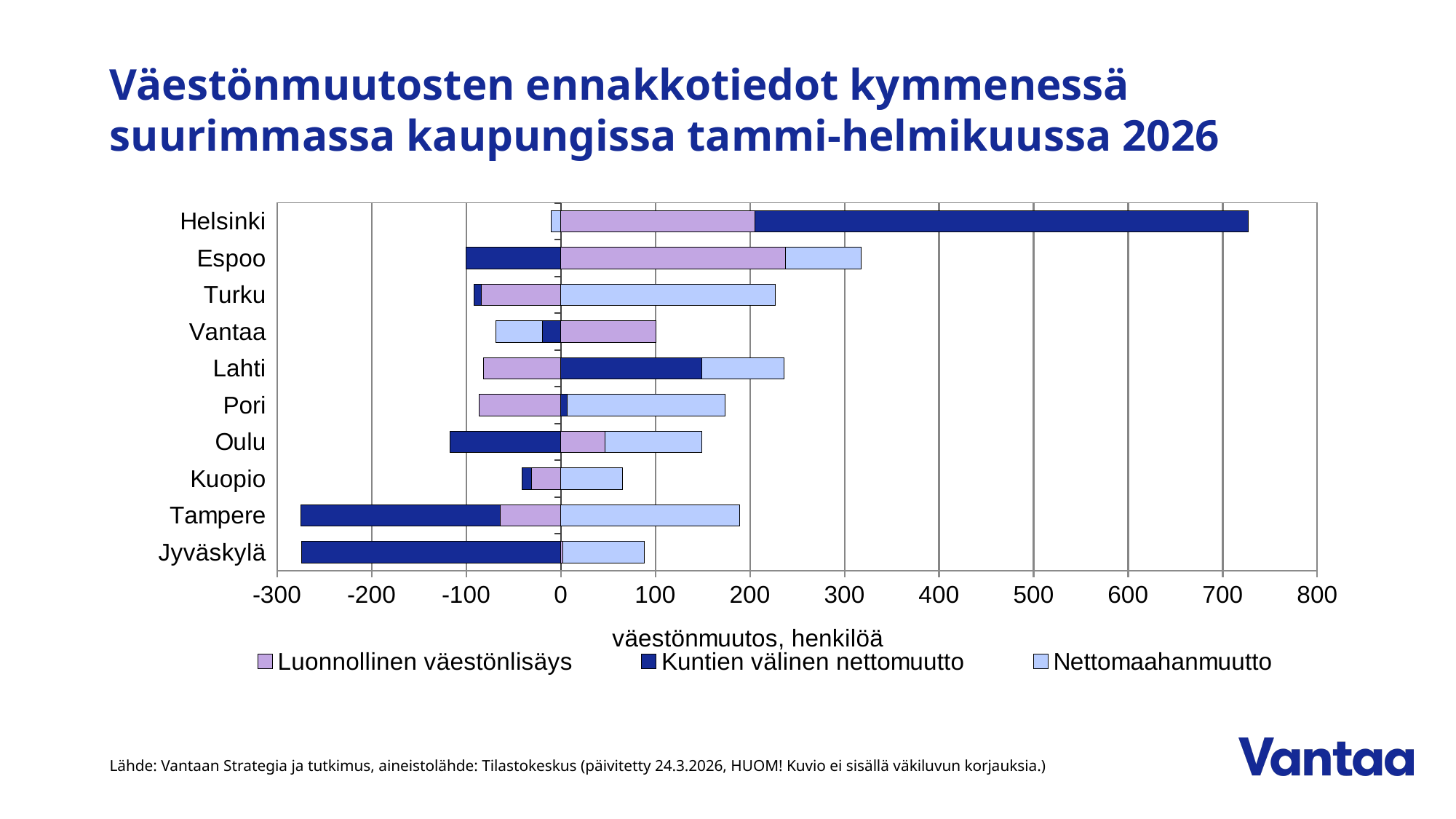
Is the Kuntien välinen nettomuutto for Jyväskylä greater or less than -200? less How many cities are shown on the chart? 10 Is the Kuntien välinen nettomuutto for Lahti greater or less than 100? greater Which city has the most negative Kuntien välinen nettomuutto? Jyväskylä Which city has the largest Kuntien välinen nettomuutto? Helsinki What is the x-axis title of the chart? väestönmuutos, henkilöä Is the Luonnollinen väestönlisäys for Espoo greater or less than 200? greater What kind of chart is shown on the slide? Stacked bar chart How many series does the legend list? 3 Which series is shown in dark blue in the legend? Kuntien välinen nettomuutto Which city has the larger Luonnollinen väestönlisäys, Espoo or Vantaa? Espoo